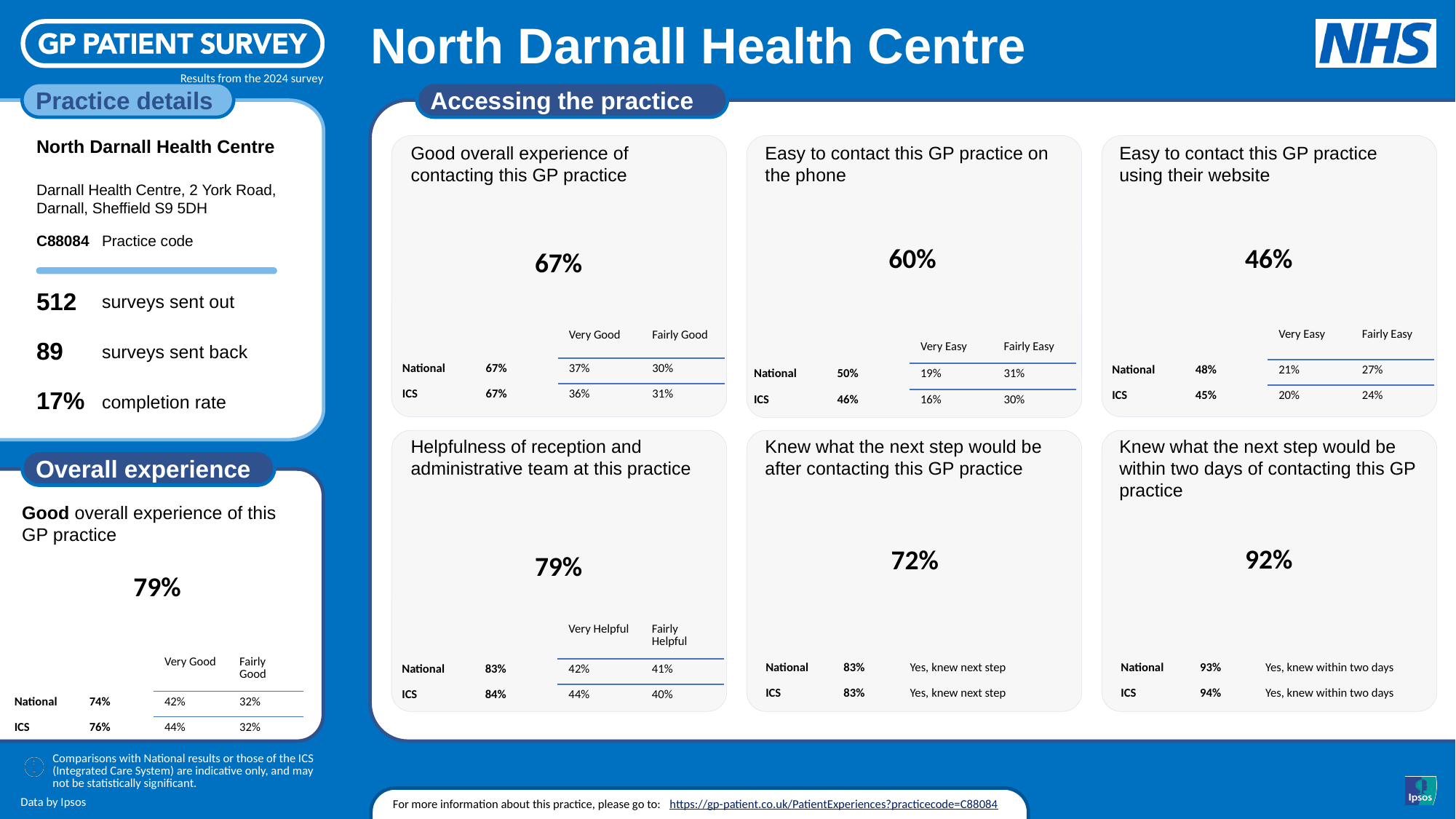
In the 'Overall experience' section, what is the practice's value for good overall experience of this GP practice? 79% Which of the six 'Accessing the practice' panels shows the lowest headline value? Easy to contact this GP practice using their website In the 'Easy to contact this GP practice on the phone' panel, is the practice's headline value (60%) larger or smaller than the National value (50%)? larger In the 'Easy to contact this GP practice on the phone' panel, what is the practice's headline value? 60% In the 'Helpfulness of reception and administrative team at this practice' panel, what is the practice's headline value? 79% In the 'Knew what the next step would be after contacting this GP practice' panel, what is the practice's headline value? 72% Which of the six 'Accessing the practice' panels shows the highest headline value? Knew what the next step would be within two days of contacting this GP practice What is the difference between the practice's headline value for contacting on the phone (60%) and using the website (46%)? 14% In the 'Easy to contact this GP practice using their website' panel, what is the practice's headline value? 46% In the 'Overall experience' section, what is the National value for good overall experience? 74% In the 'Knew what the next step would be within two days of contacting this GP practice' panel, what is the practice's headline value? 92% In the 'Good overall experience of contacting this GP practice' panel, what is the practice's headline value? 67%